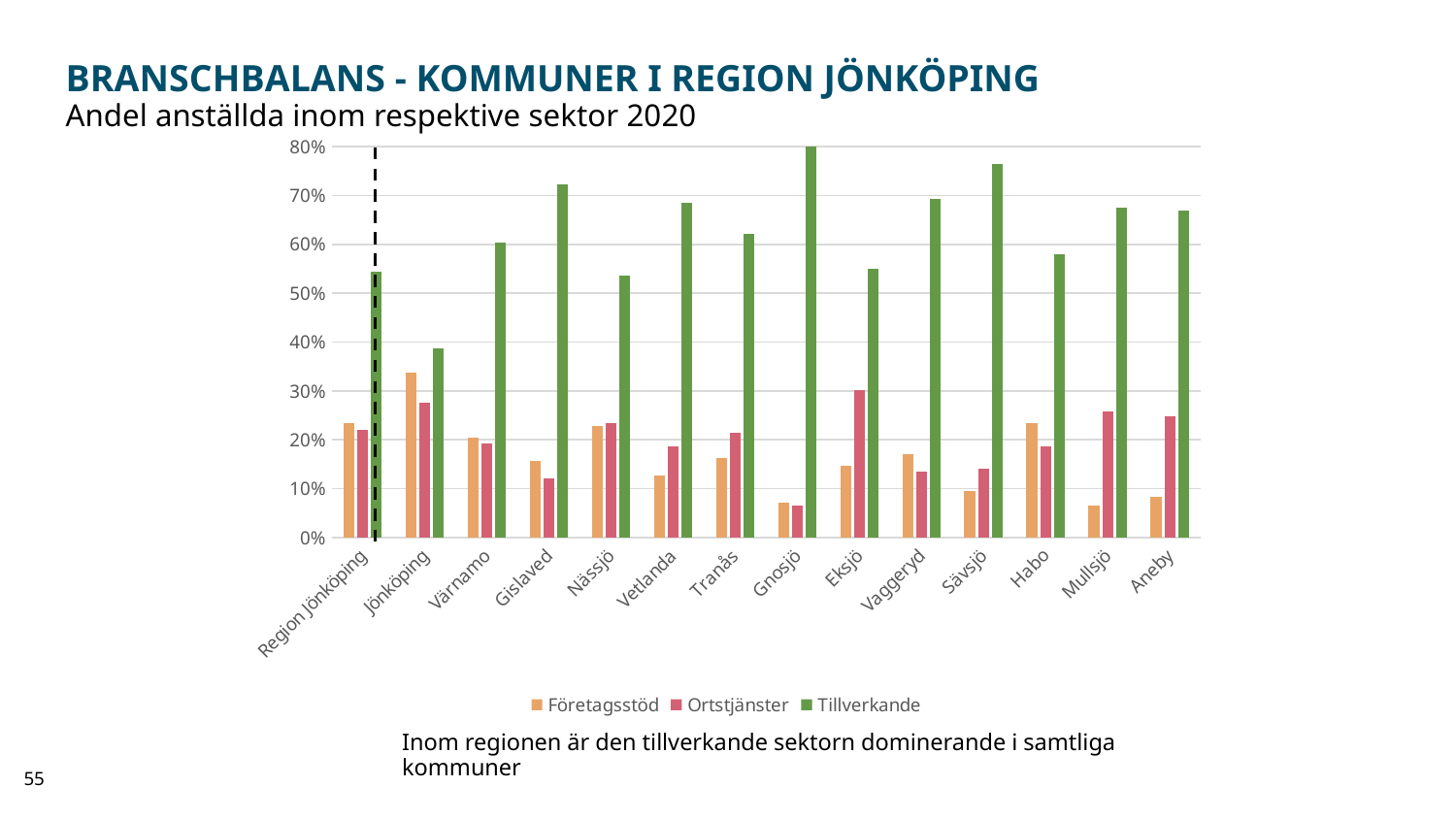
What is the title of the chart? BRANSCHBALANS - KOMMUNER I REGION JÖNKÖPING Which category has the highest Ortstjänster value? Eksjö Which category has the highest Tillverkande value? Gnosjö Which category has the highest Företagsstöd value? Jönköping What kind of chart is shown on the slide? bar chart Is the Tillverkande value for Jönköping greater or less than 40%? less Is the Tillverkande value for Gnosjö greater or less than 70%? greater Is the Tillverkande value for Gnosjö larger than the Tillverkande value for Jönköping? Yes How many municipalities/categories are shown on the x axis? 14 Which category has the lowest Ortstjänster value? Gnosjö How many series does the legend list? 3 Which category has the lowest Tillverkande value? Jönköping